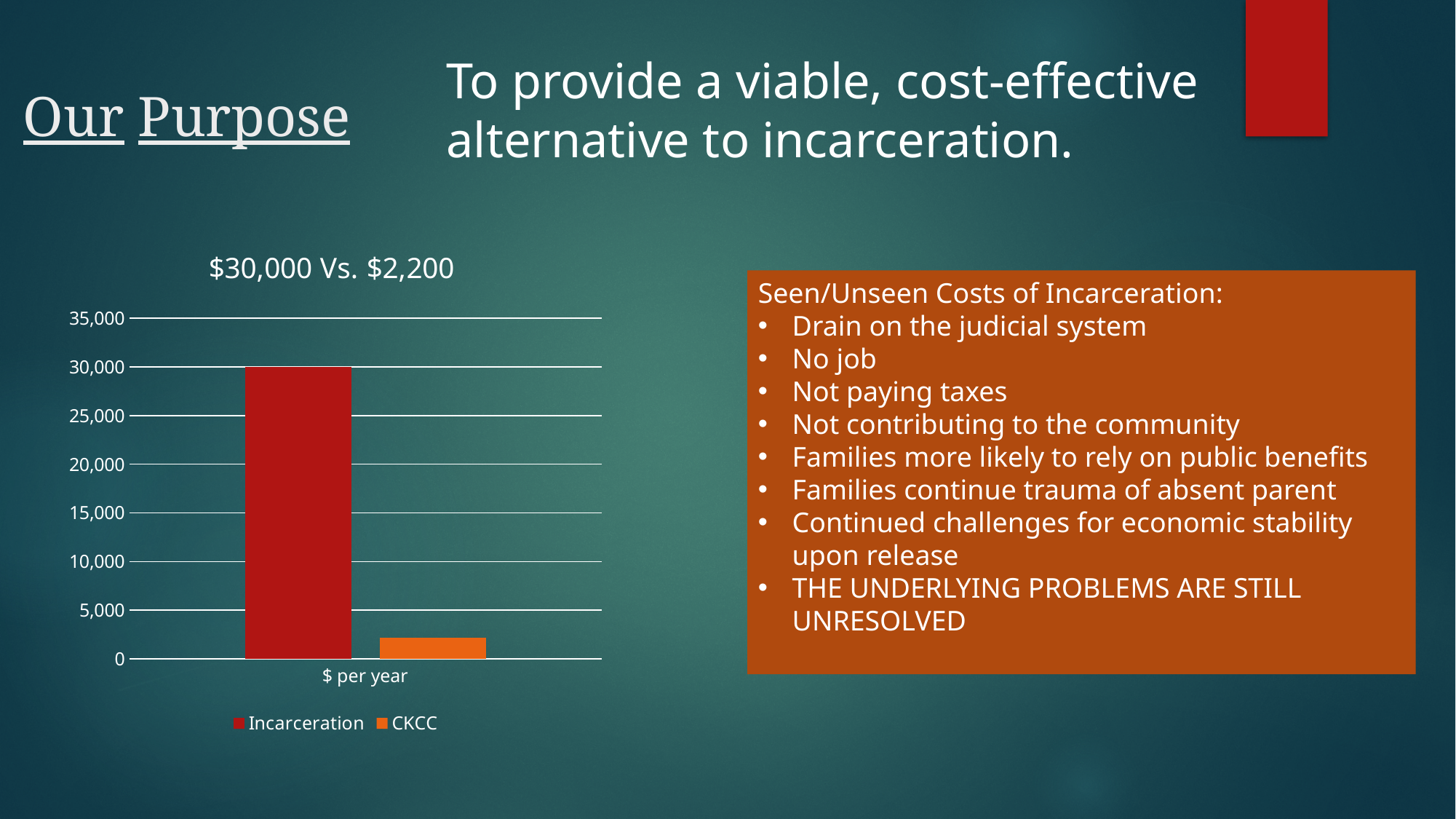
What are the two series named in the chart legend? Incarceration and CKCC Is the value for CKCC greater or less than 5,000? less Is the value for Incarceration greater or less than 25,000? greater How many series does the chart legend list? 2 Which series has the lowest value in the chart? CKCC What is the title of the chart? $30,000 Vs. $2,200 What is the value of the CKCC bar in $ per year? $2,200 Which series has the higher value, Incarceration or CKCC? Incarceration What is the difference between the Incarceration value and the CKCC value? $27,800 What is the value of the Incarceration bar in $ per year? 30,000 How many categories are shown on the x axis of the chart? 1 What kind of chart is shown on the slide? Bar chart